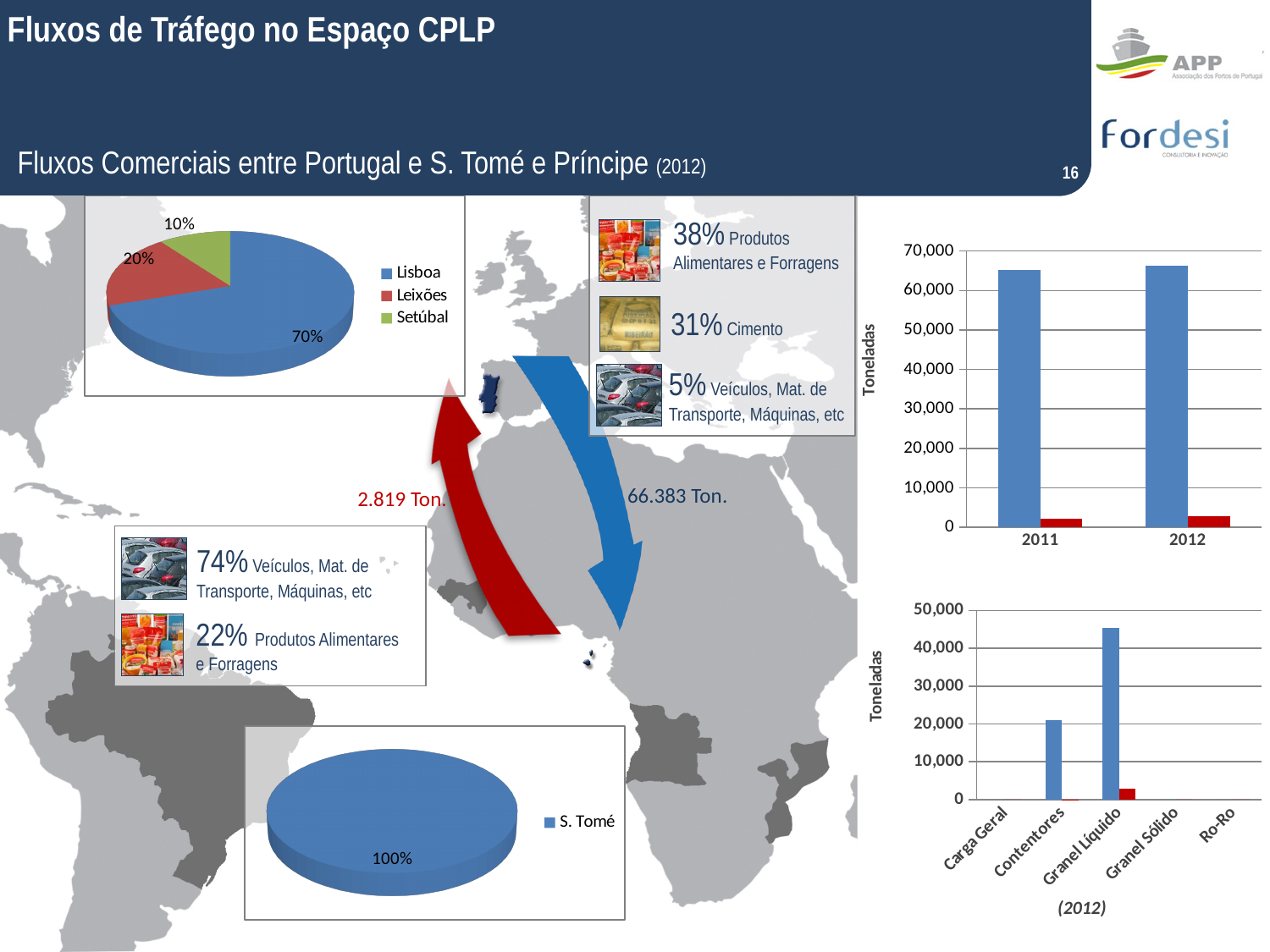
In the top-left pie chart, what share does Lisboa have? 70% In the bottom-right bar chart, which category has the tallest blue bar? Granel Líquido What kind of chart is the chart at the top right of the slide? bar chart In the top-right bar chart, is the value of the blue bar for 2011 greater or less than 60,000? greater How many slices does the top-left pie chart have? 3 In the top-left pie chart, which port has the smallest slice? Setúbal In the bottom-left pie chart, what share does S. Tomé have? 100% How many categories are shown on the x axis of the bottom-right bar chart? 5 In the top-left pie chart, what share does Leixões have? 20% In the top-right bar chart, is the value of the red bar for 2012 greater or less than 10,000? less In the top-left pie chart, what share does Setúbal have? 10% In the top-left pie chart, which port has the largest slice? Lisboa